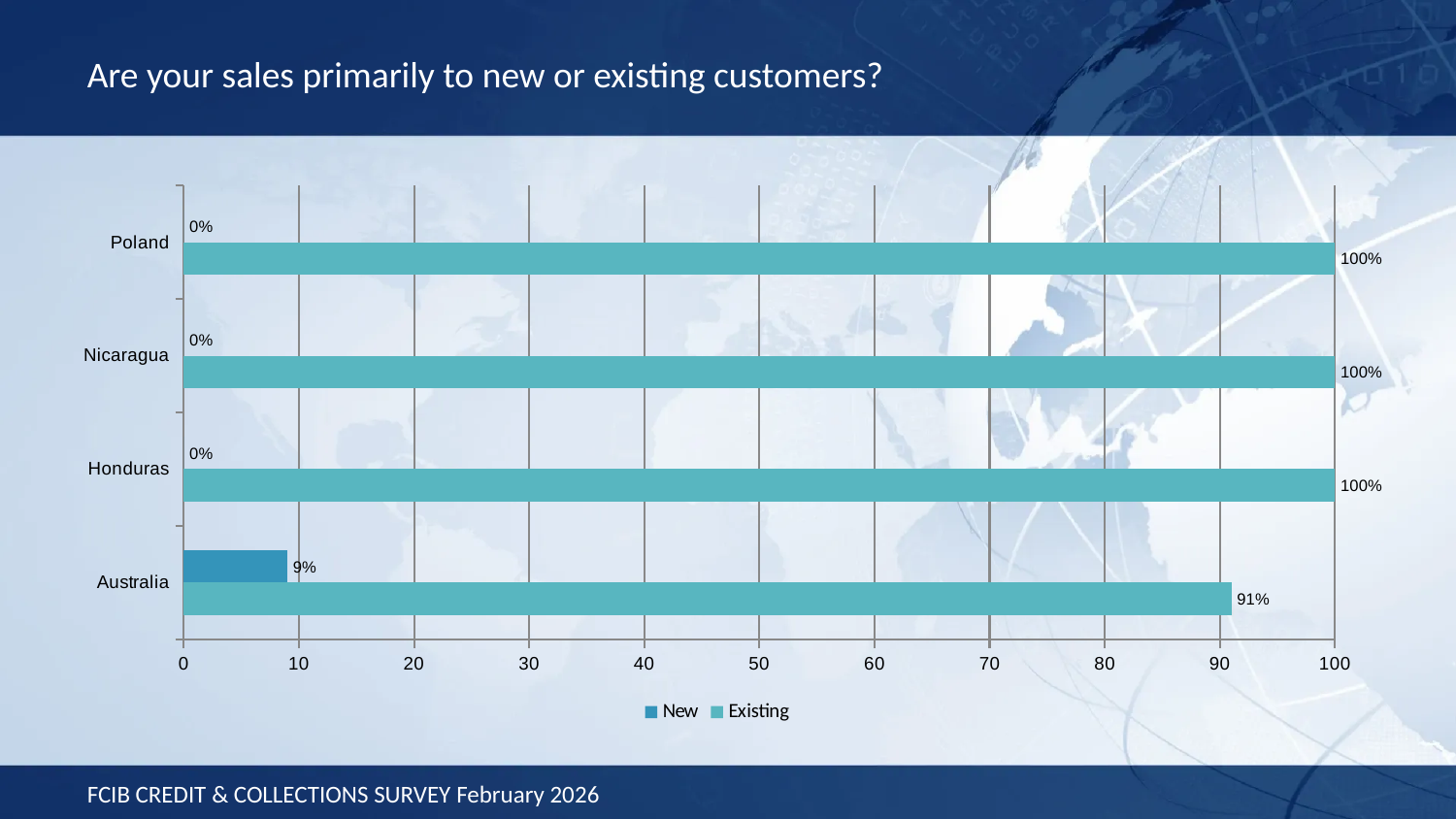
What are the two series named in the legend? New and Existing Is the Existing value for Nicaragua larger or smaller than the Existing value for Australia? larger What percentage of Australia's sales are to new customers? 9% What is the value for New customers for Honduras? 0% What type of chart is shown on the slide? Bar chart How many countries are shown on the chart? 4 What percentage of Australia's sales are to existing customers? 91% How many series does the legend list? 2 What is the value for Existing customers for Poland? 100% Which country has the lowest share of sales to existing customers? Australia What is the difference between Australia's Existing and New percentages? 82% Which country has the highest share of sales to new customers? Australia